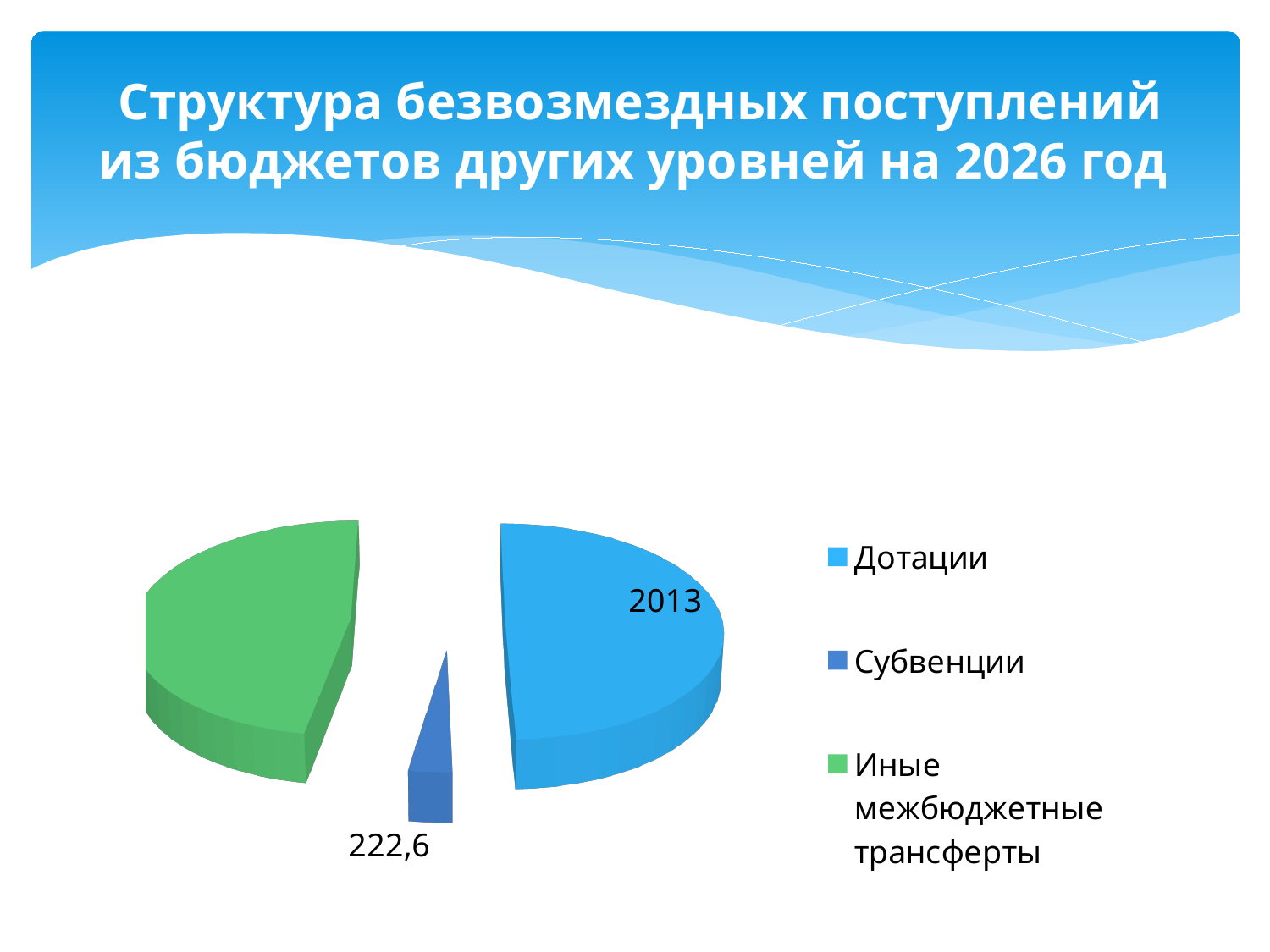
What is the title of the slide? Структура безвозмездных поступлений из бюджетов других уровней на 2026 год Which is larger, the value for Дотации or the value for Субвенции? Дотации Which category is shown in green on the pie chart? Иные межбюджетные трансферты How many slices does the pie chart have? 3 What is the difference between the values for Дотации and Субвенции? 1790,4 How many entries does the legend list? 3 What kind of chart is shown on the slide? Pie chart What value is shown for Субвенции on the pie chart? 222,6 Is the value for Субвенции greater or less than 1000? less What value is shown for Дотации on the pie chart? 2013 Which category has the smallest slice of the pie chart? Субвенции